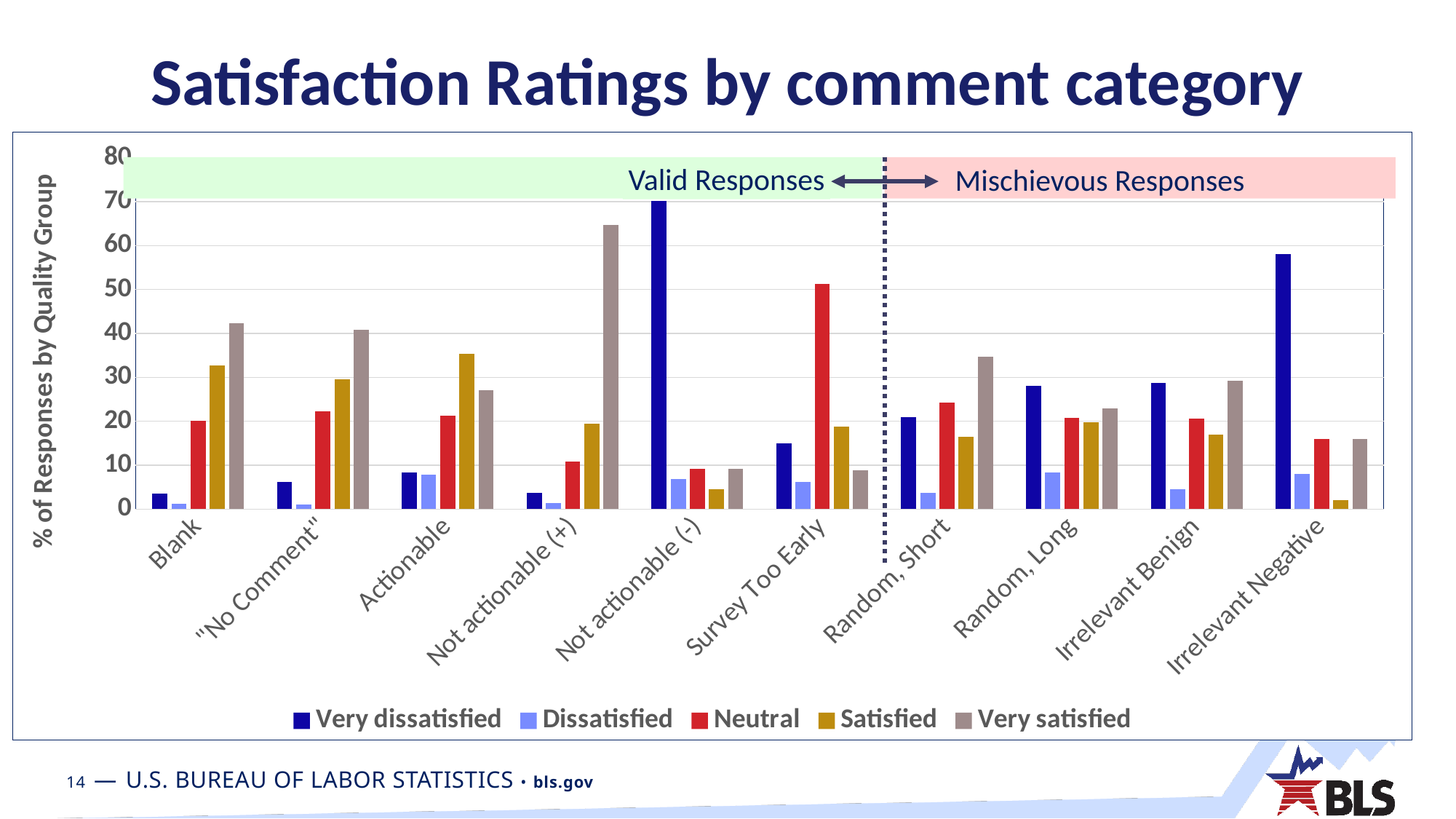
Which comment category has the highest Very dissatisfied value? Not actionable (-) Which comment category has the highest Neutral value? Survey Too Early Which comment category has the highest Very satisfied value? Not actionable (+) Is the Very dissatisfied value for Irrelevant Negative greater or less than 50? greater Is the Satisfied value for Irrelevant Negative greater or less than 10? less What is the label of the y axis? % of Responses by Quality Group What kind of chart is shown on the slide? bar chart Which is larger for Actionable: the Satisfied value or the Very satisfied value? Satisfied Which is larger for Random, Short: the Very satisfied value or the Neutral value? Very satisfied How many series does the legend list? 5 Is the Very satisfied value for Blank greater or less than 40? greater How many comment categories are shown on the x axis? 10